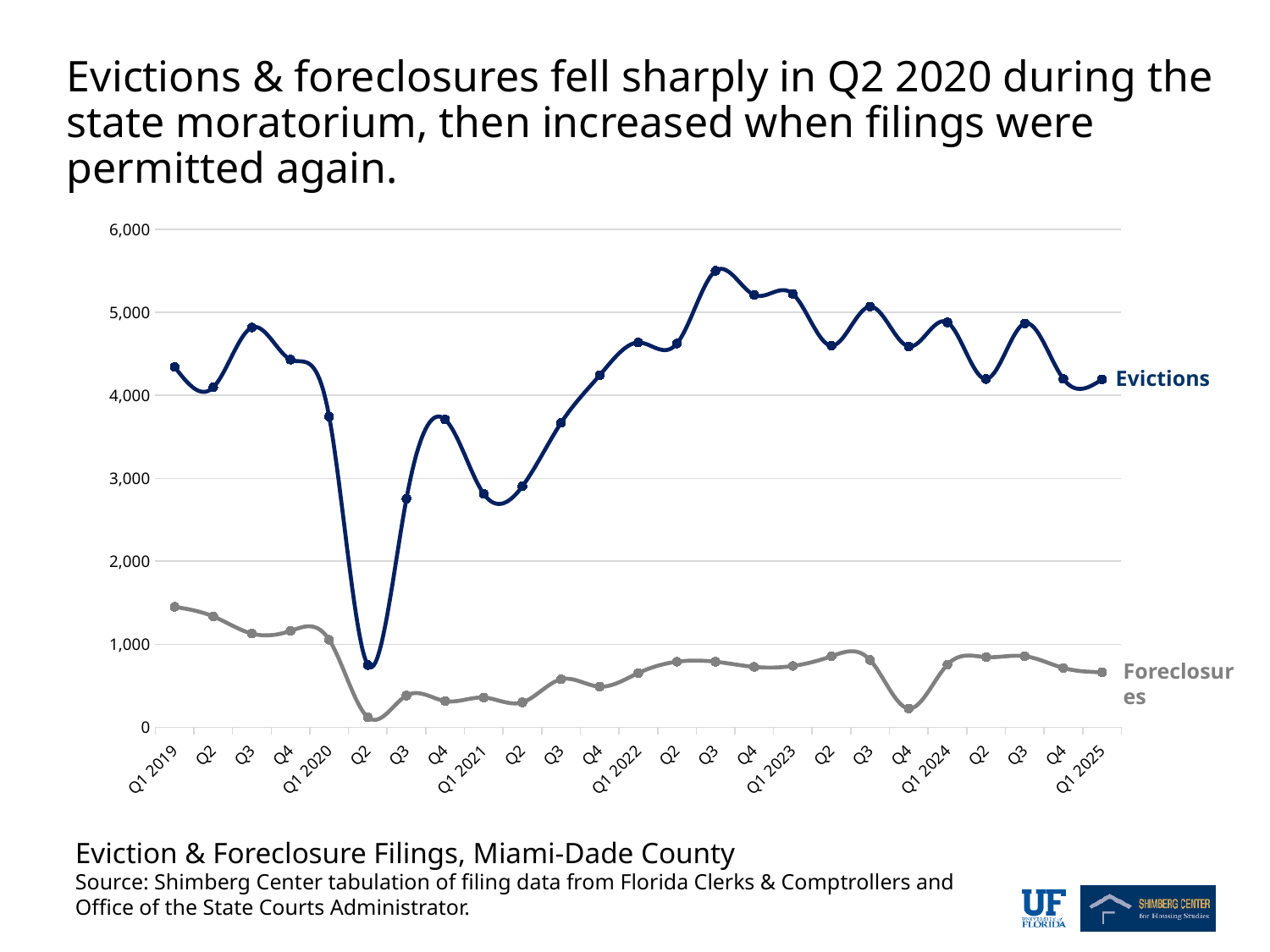
In which quarter do Evictions reach their lowest value? Q2 2020 Is the value for Foreclosures in Q4 2023 greater or less than 500? less Is the value for Evictions in Q3 2022 greater or less than 5,000? greater Do Foreclosures rise or fall from Q1 2019 to Q2 2020? fall In which quarter do Foreclosures reach their lowest value? Q2 2020 How many series are plotted on the chart? 2 What kind of chart is shown on the slide? line chart In which quarter do Evictions reach their highest value? Q3 2022 Which series has the higher value in Q1 2025, Evictions or Foreclosures? Evictions Is the value for Foreclosures in Q1 2019 greater or less than 1,000? greater How many quarters are plotted along the x axis, from Q1 2019 to Q1 2025? 25